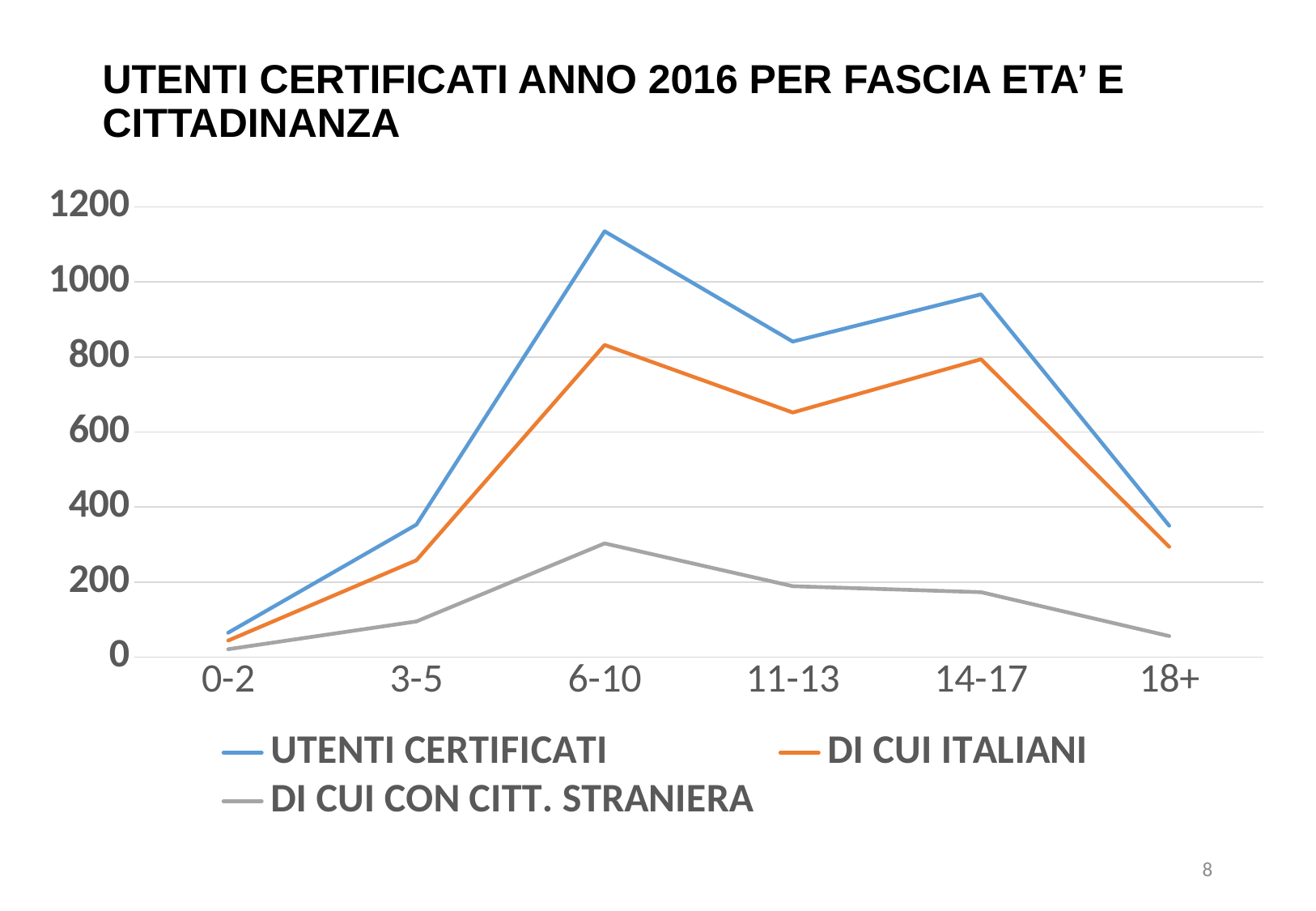
For which age group is DI CUI CON CITT. STRANIERA highest? 6-10 Which series is drawn in orange? DI CUI ITALIANI Is the value of UTENTI CERTIFICATI for 6-10 greater or less than 1000? greater What type of chart is shown on the slide? line chart For which age group is UTENTI CERTIFICATI highest? 6-10 Is the value of DI CUI ITALIANI for 11-13 greater or less than 800? less Which is larger for UTENTI CERTIFICATI: the value for 14-17 or the value for 11-13? 14-17 For which age group is UTENTI CERTIFICATI lowest? 0-2 How many series does the legend list? 3 How many age-group categories are shown on the x axis? 6 Does UTENTI CERTIFICATI rise or fall from 14-17 to 18+? fall Is the value of DI CUI CON CITT. STRANIERA for 6-10 greater or less than 200? greater